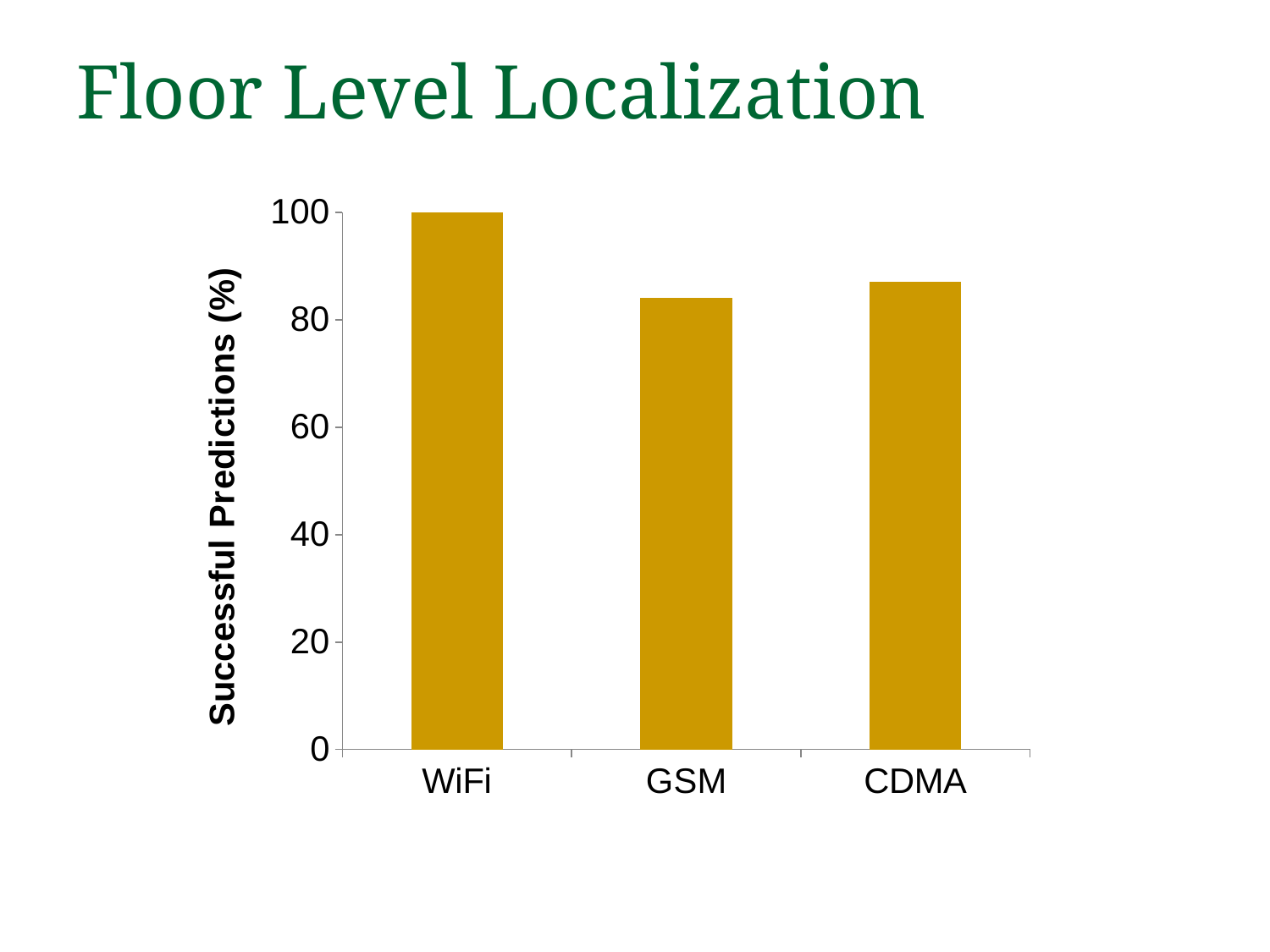
Which category has the lowest value in the chart? GSM Is the value for GSM greater or less than 100? less Which is larger, the value for CDMA or the value for GSM? CDMA Which is larger, the value for WiFi or the value for GSM? WiFi Is the value for GSM greater or less than 80? greater What is the label of the y axis in the chart? Successful Predictions (%) Which category has the highest value in the chart? WiFi Is the value for CDMA greater or less than 80? greater What is the value for WiFi in the chart? 100 What type of chart is shown on the slide? bar chart How many categories are shown on the x axis of the chart? 3